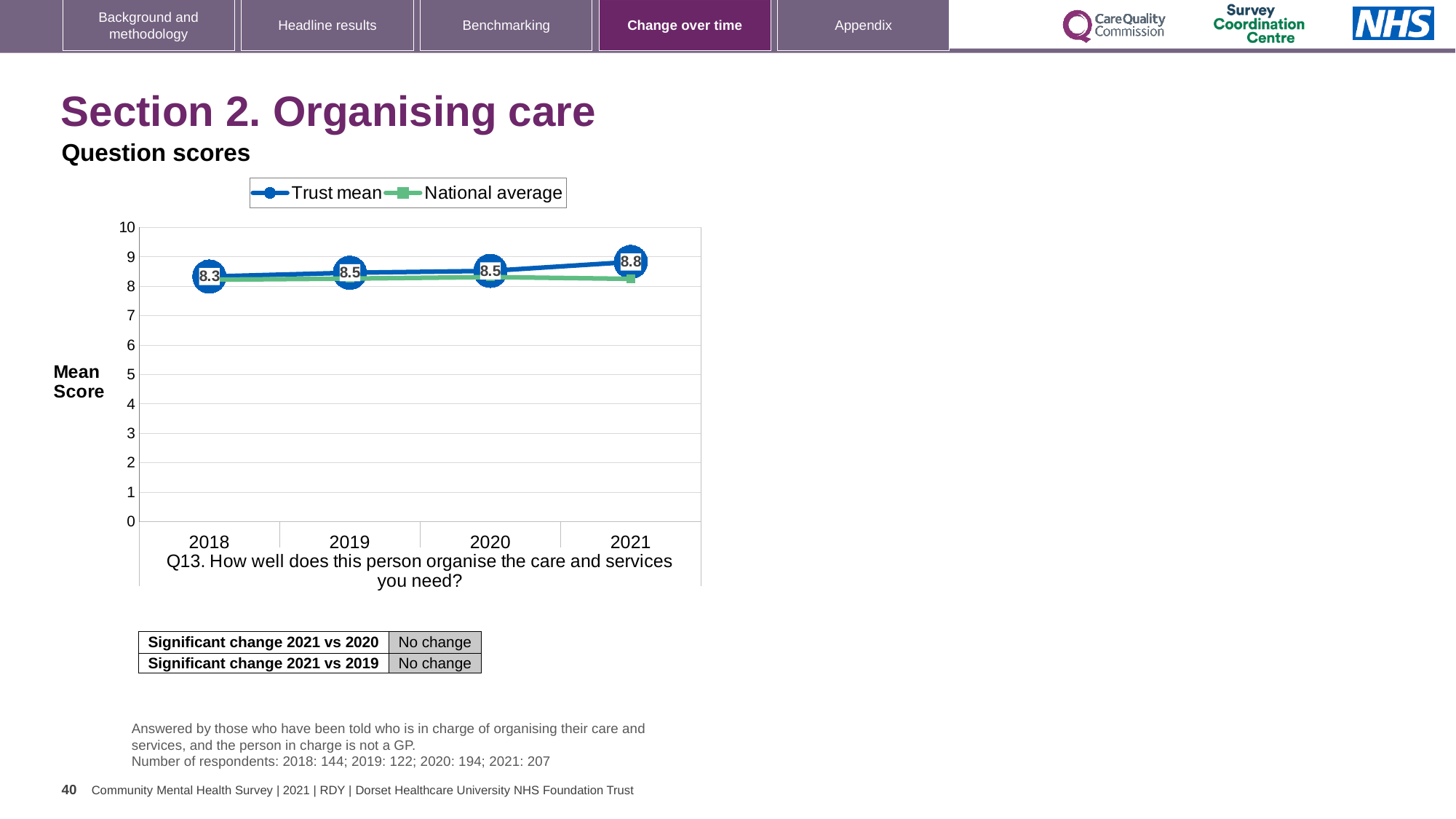
What is the Trust mean for 2018? 8.3 Which is larger, the Trust mean in 2021 or the Trust mean in 2020? 2021 What is the difference between the Trust mean in 2021 and in 2018? 0.5 Does the Trust mean rise or fall from 2018 to 2021? rise How many series does the legend list? 2 In which year is the Trust mean lowest? 2018 How many years are shown on the x axis? 4 In which year is the Trust mean highest? 2021 What is the Trust mean for 2020? 8.5 What kind of chart is shown on the slide? line chart What is the Trust mean for 2021? 8.8 Is the National average for 2021 greater or less than 7? greater